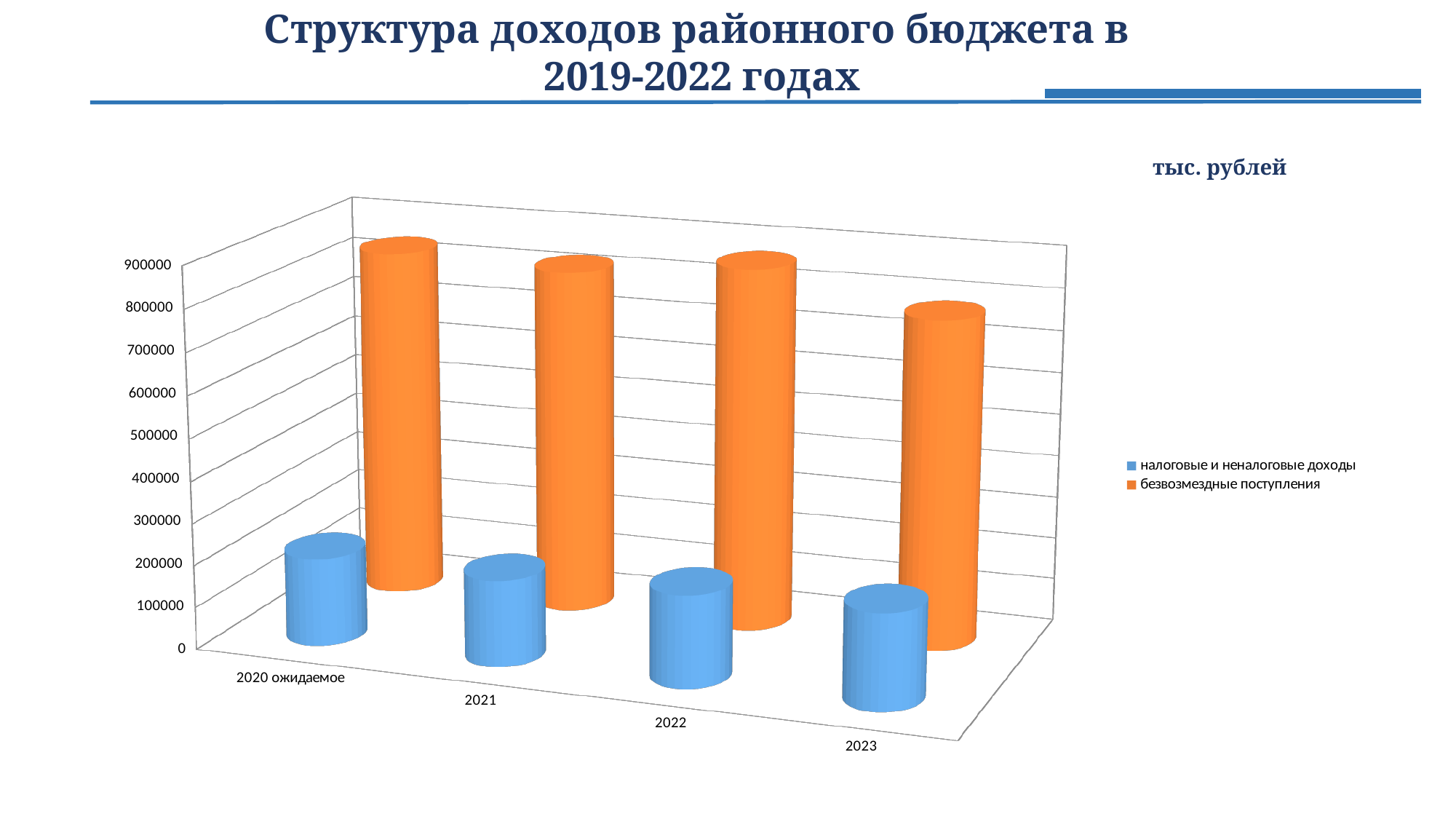
Is the value of налоговые и неналоговые доходы for 2020 ожидаемое greater or less than 400000? less What is the label of the first category on the x axis of the chart? 2020 ожидаемое Which series is shown in orange in the chart? безвозмездные поступления For 2023, which is larger: налоговые и неналоговые доходы or безвозмездные поступления? безвозмездные поступления What kind of chart is shown on the slide? bar chart How many series does the chart legend list? 2 For 2021, which is larger: налоговые и неналоговые доходы or безвозмездные поступления? безвозмездные поступления Is the value of безвозмездные поступления for 2022 greater or less than 500000? greater How many categories are shown along the x axis of the chart? 4 What unit of measurement is indicated above the chart? тыс. рублей Is the value of налоговые и неналоговые доходы for 2022 greater or less than 500000? less